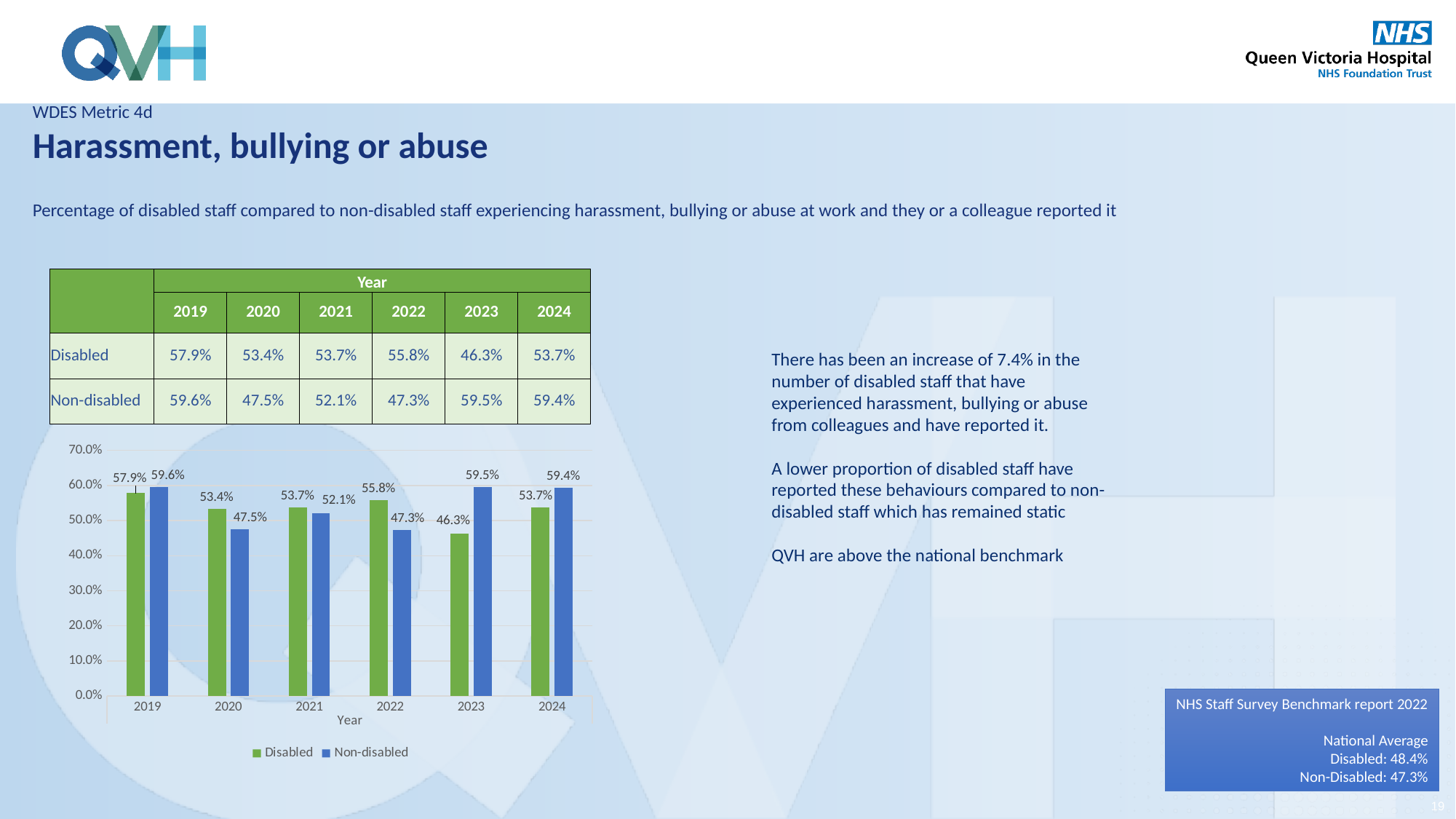
What is the value for Non-disabled staff in 2022? 47.3% How many series does the chart legend list? 2 Is the value for Disabled staff in 2023 greater or less than 50.0%? less What is the difference between the Non-disabled and Disabled values in 2023? 13.2% In 2022, which is larger: the Disabled value or the Non-disabled value? Disabled What is the value for Disabled staff in 2023? 46.3% Which colour represents Non-disabled staff in the chart? Blue Which year has the highest value for Non-disabled staff? 2019 What is the value for Disabled staff in 2019? 57.9% What kind of chart is shown on the slide? Bar chart Which year has the lowest value for Disabled staff? 2023 How many years are shown on the x axis of the chart? 6